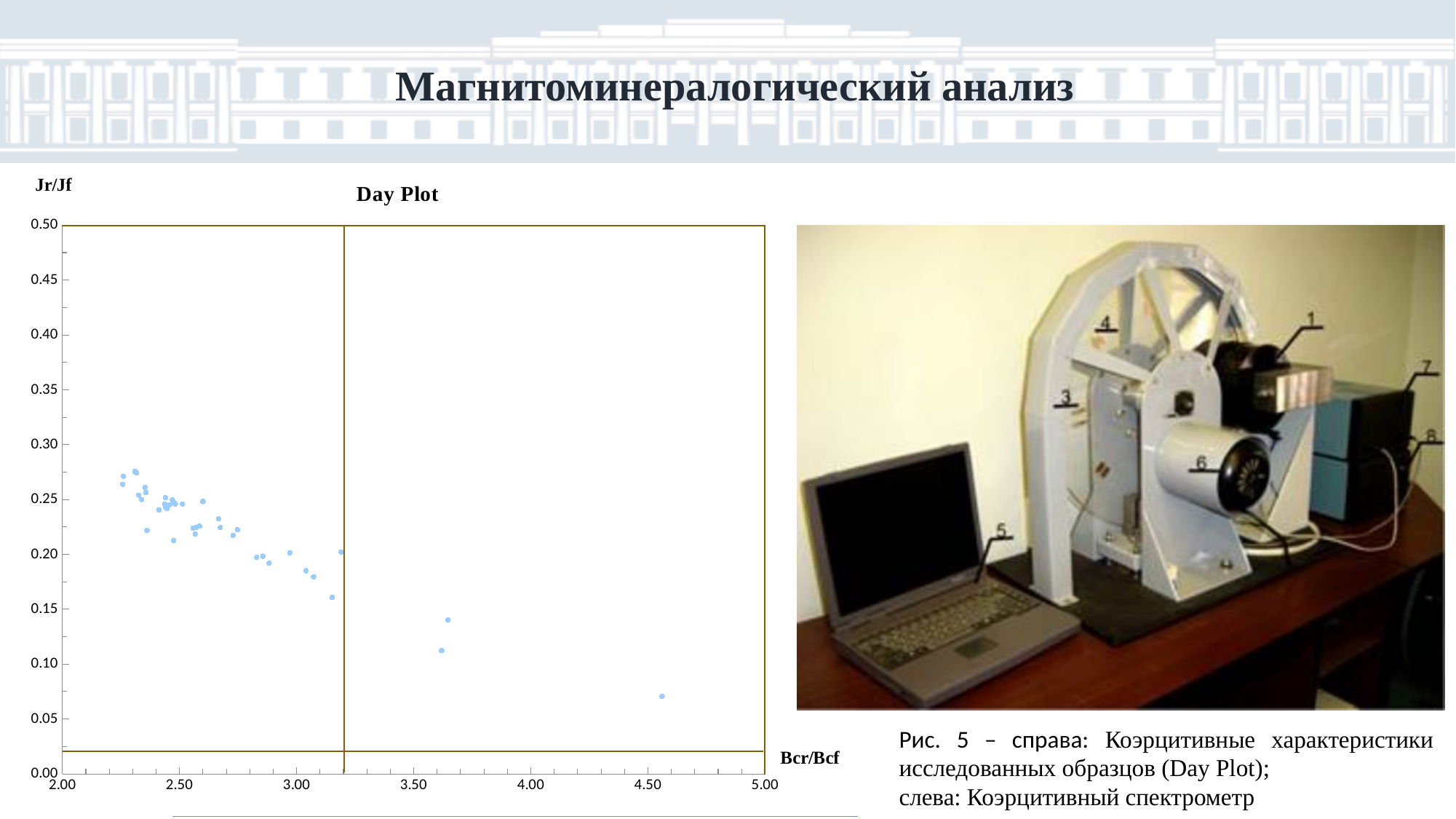
In the Day Plot, is the Jr/Jf value of the highest point greater or less than 0.30? less In the Day Plot, is the Jr/Jf value of the lowest point greater or less than 0.05? greater In the Day Plot, are all the points with Bcr/Bcf below 3.00 above or below a Jr/Jf value of 0.15? above In the Day Plot, do the Jr/Jf values generally rise or fall as Bcr/Bcf increases? fall What label is shown on the x axis of the Day Plot? Bcr/Bcf In the Day Plot, how many points have a Bcr/Bcf value greater than 3.50? 3 What is the title of the chart on the left of the slide? Day Plot What kind of chart is the Day Plot? scatter chart